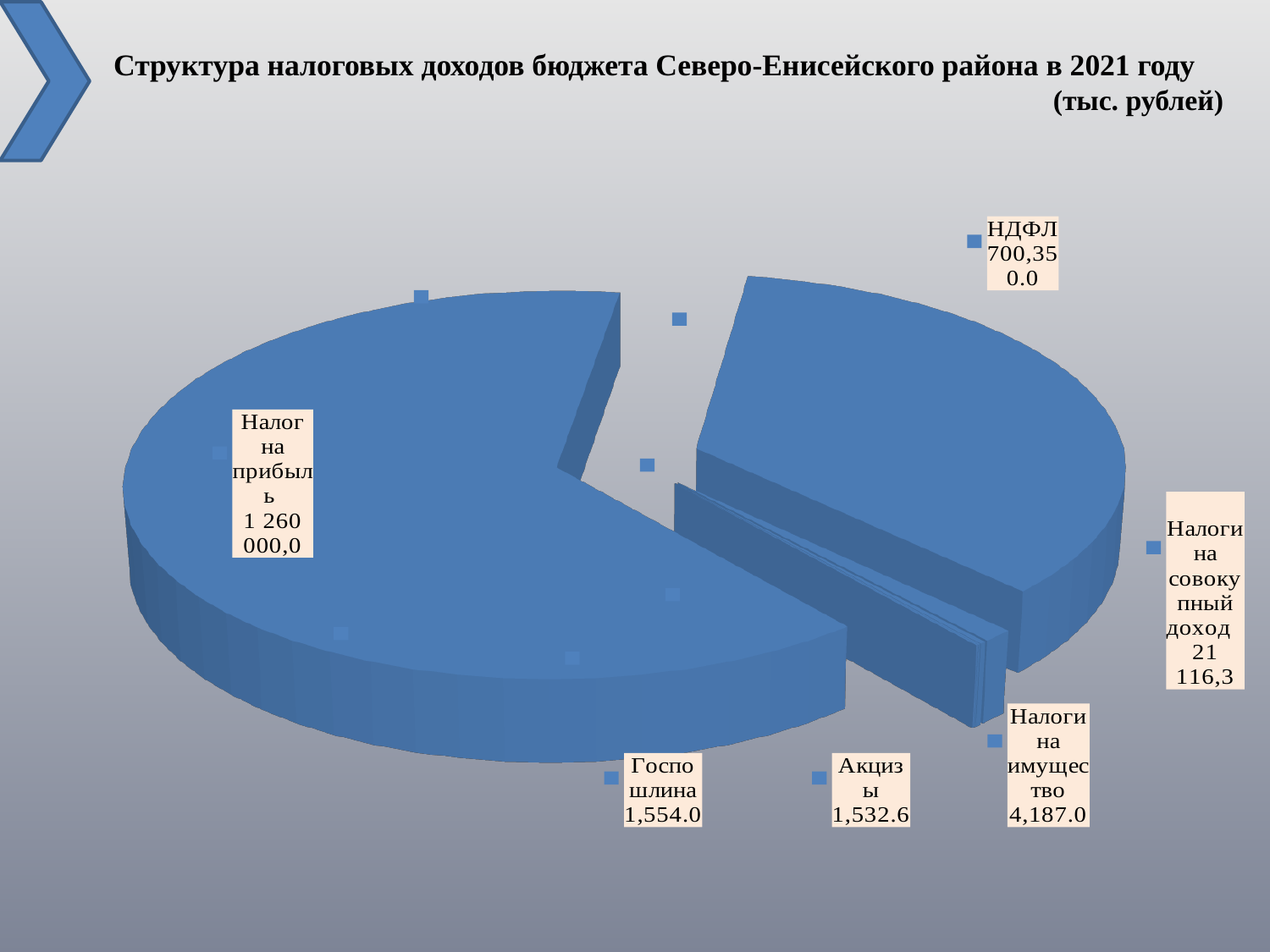
What is the value for Акцизы? 1,532.6 What is the value for Налоги на совокупный доход? 21 116,3 Which category has the largest value? Налог на прибыль What is the value for НДФЛ? 700,350.0 What kind of chart is shown on the slide? Pie chart What is the value for Налог на прибыль? 1 260 000,0 Which is larger, Налоги на имущество or Госпошлина? Налоги на имущество Which category has the smallest value? Акцизы What is the difference between Налоги на имущество and Госпошлина? 2,633.0 What is the value for Налоги на имущество? 4,187.0 What is the value for Госпошлина? 1,554.0 How many categories are shown in the chart? 6